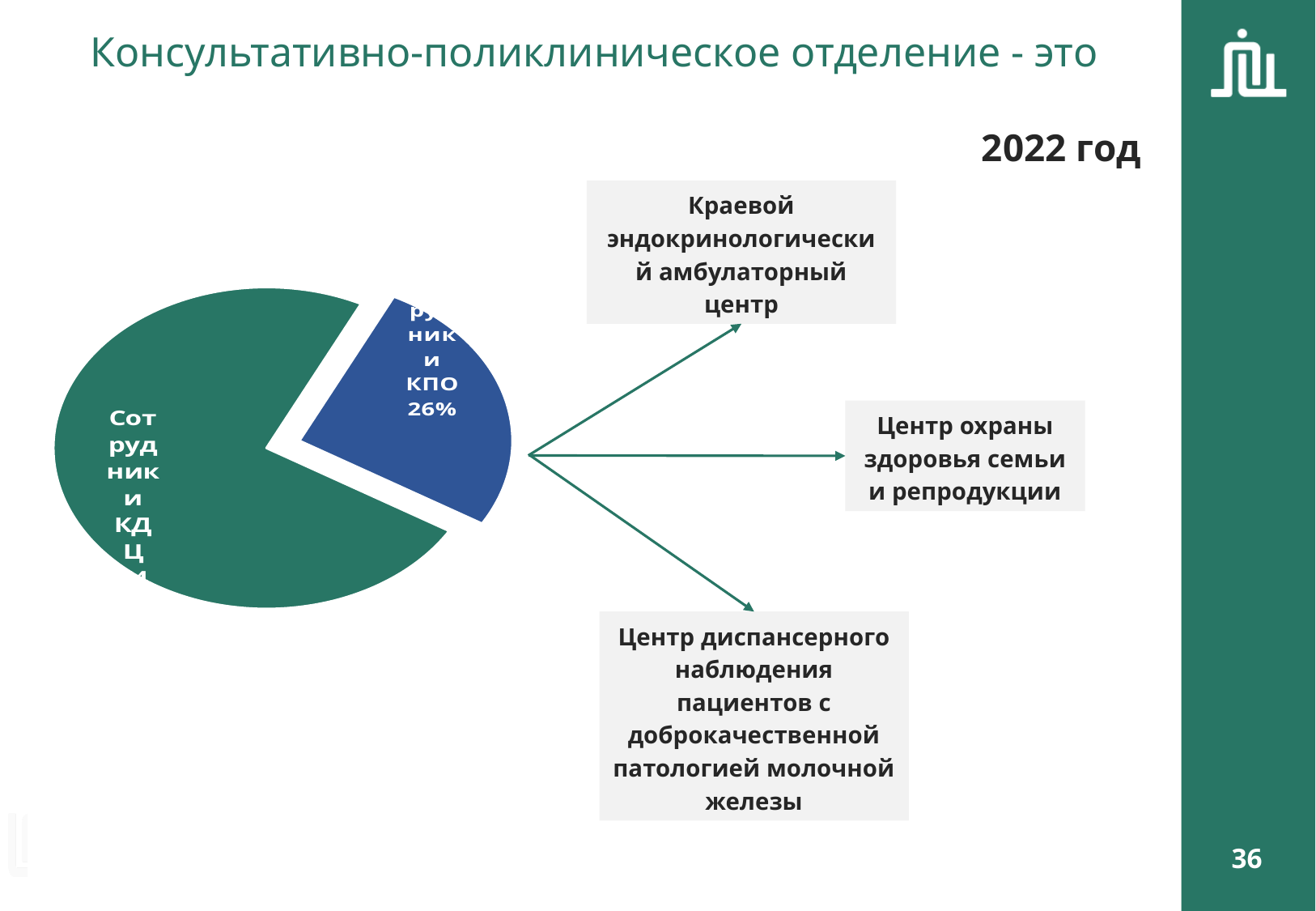
What kind of chart is shown on the slide? pie chart What colour is the Сотрудники КПО slice in the pie chart? blue What share of the pie chart is labelled for Сотрудники КПО? 26% Is the share for Сотрудники КПО greater or less than 50%? less Which slice of the pie chart is the largest? Сотрудники КДЦ Which is larger in the pie chart: Сотрудники КДЦ or Сотрудники КПО? Сотрудники КДЦ Which slice of the pie chart is the smallest? Сотрудники КПО What colour is the Сотрудники КДЦ slice in the pie chart? green How many slices does the pie chart have? 2